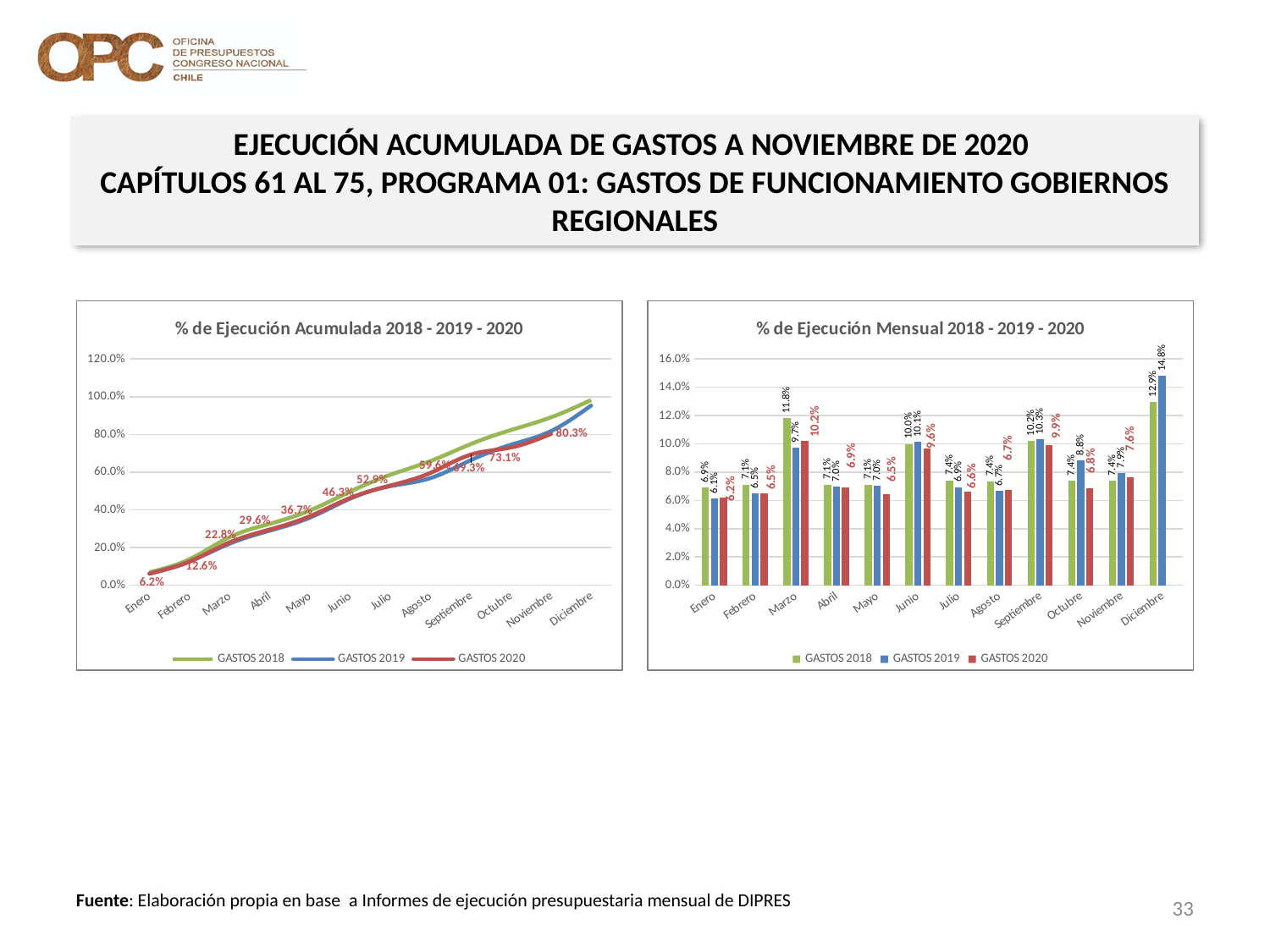
What kind of chart is the left chart '% de Ejecución Acumulada 2018 - 2019 - 2020'? Line chart What kind of chart is the right chart '% de Ejecución Mensual 2018 - 2019 - 2020'? Bar chart In the left chart '% de Ejecución Acumulada 2018 - 2019 - 2020', what is the value for GASTOS 2020 in Noviembre? 80.3% In the left chart '% de Ejecución Acumulada 2018 - 2019 - 2020', what is the difference between the GASTOS 2020 values for Noviembre and Octubre? 7.2 percentage points In the right chart '% de Ejecución Mensual 2018 - 2019 - 2020', what is the difference between GASTOS 2018 and GASTOS 2019 in Marzo? 2.1 percentage points How many series does the legend of the left chart '% de Ejecución Acumulada 2018 - 2019 - 2020' list? 3 In the right chart '% de Ejecución Mensual 2018 - 2019 - 2020', what is the value for GASTOS 2018 in Marzo? 11.8% In the right chart '% de Ejecución Mensual 2018 - 2019 - 2020', which month has the highest value for GASTOS 2020? Marzo In the right chart '% de Ejecución Mensual 2018 - 2019 - 2020', what is the value for GASTOS 2019 in Diciembre? 14.8% In the left chart '% de Ejecución Acumulada 2018 - 2019 - 2020', do the GASTOS 2020 values rise or fall from Enero to Noviembre? Rise In the left chart '% de Ejecución Acumulada 2018 - 2019 - 2020', what is the value for GASTOS 2020 in Enero? 6.2% In the right chart '% de Ejecución Mensual 2018 - 2019 - 2020', which is larger in Octubre: GASTOS 2019 or GASTOS 2020? GASTOS 2019